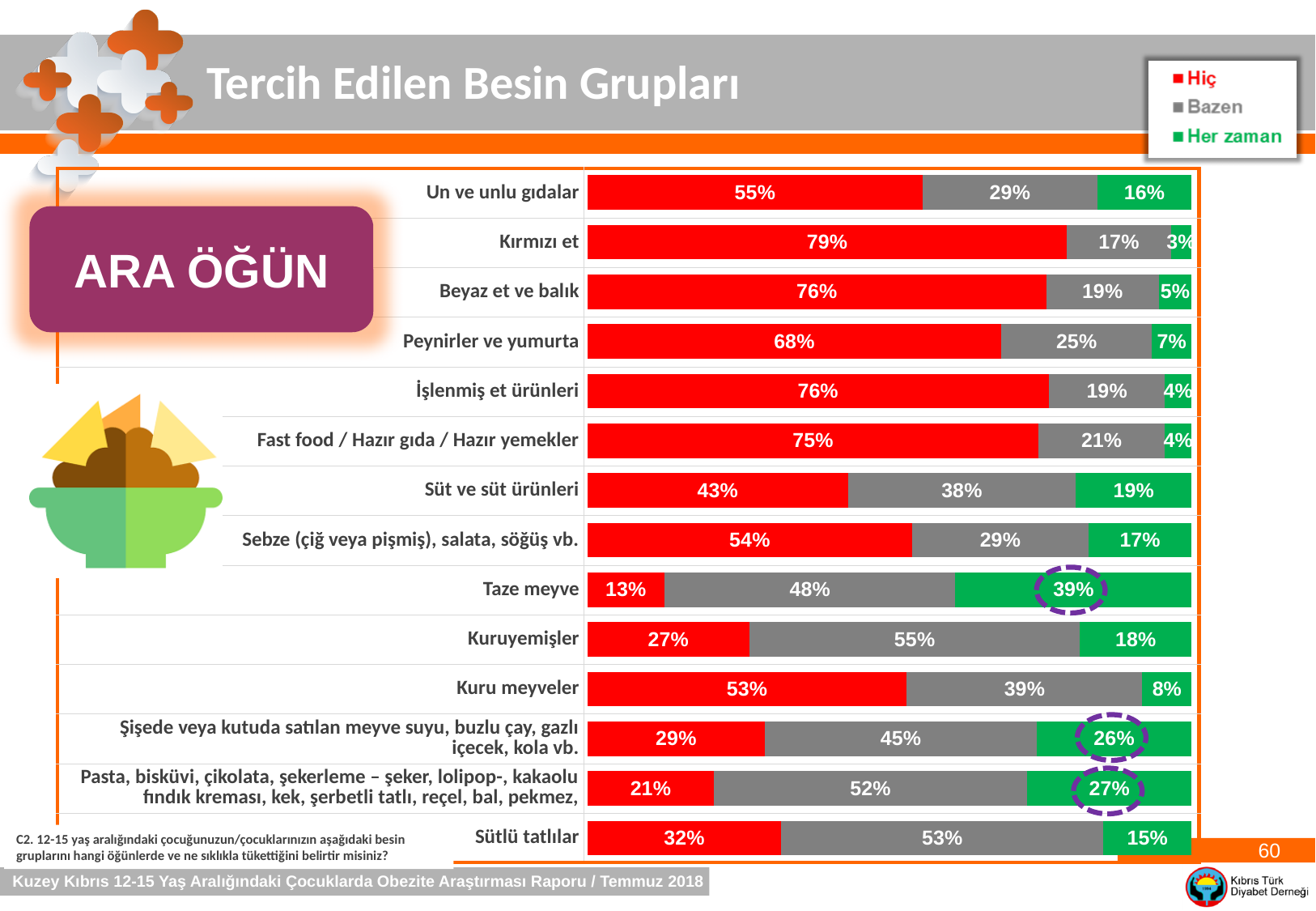
What kind of chart is shown on the slide? Stacked bar chart What is the difference between the "Hiç" values for Un ve unlu gıdalar and Süt ve süt ürünleri? 12% Which category has the highest "Hiç" value? Kırmızı et What is the total of the stacked bar for Sütlü tatlılar? 100% How many series does the legend list? 3 What is the "Her zaman" value for Taze meyve? 39% Which category has the lowest "Hiç" value? Taze meyve What is the "Bazen" value for Kuruyemişler? 55% Which is larger: the "Her zaman" value for Süt ve süt ürünleri or for Kuru meyveler? Süt ve süt ürünleri How many food categories are shown in the chart? 14 Which colour represents "Her zaman" in the legend? Green What is the "Hiç" value for Kırmızı et? 79%